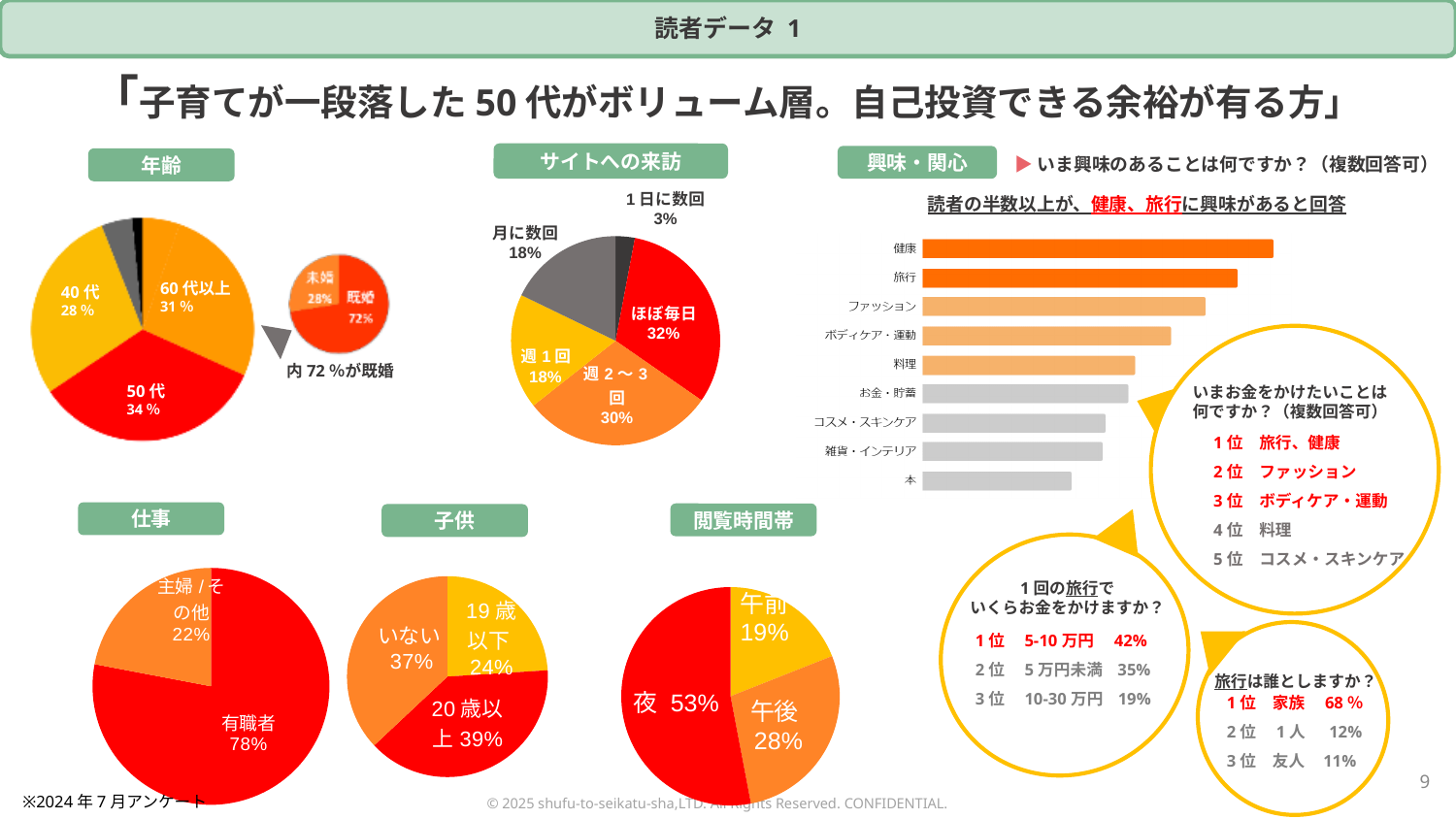
In the サイトへの来訪 pie chart, what share is ほぼ毎日? 32% In the サイトへの来訪 pie chart, which category has the smallest share? 1日に数回 In the サイトへの来訪 pie chart, what is the difference between ほぼ毎日 and 週1回? 14% In the 子供 pie chart, which is larger, いない or 20歳以上? 20歳以上 In the small 未婚/既婚 pie chart, what share is 既婚? 72% In the 興味・関心 bar chart, which category has the longest bar? 健康 In the 年齢 pie chart, what share is 50代? 34% In the 仕事 pie chart, what share is 有職者? 78% What kind of chart is the 興味・関心 chart? Bar chart In the 興味・関心 bar chart, which category has the shortest bar? 本 In the 閲覧時間帯 pie chart, what share is 夜? 53% In the 年齢 pie chart, which labelled age group has the largest share? 50代